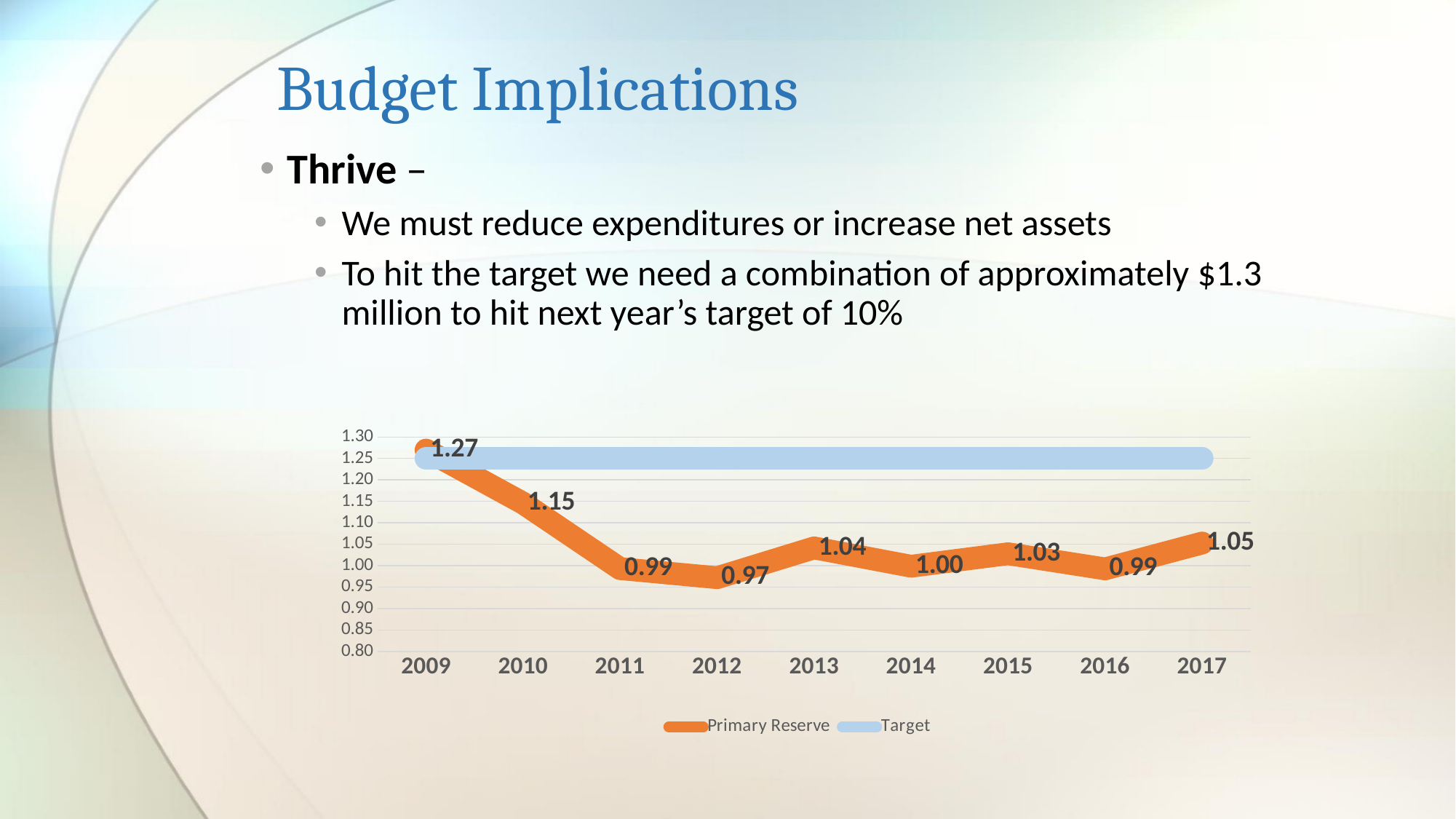
In which year is the Primary Reserve lowest? 2012 How many series does the legend list? 2 How many years are shown on the x axis? 9 What is the Primary Reserve value for 2009? 1.27 Which year has a higher Primary Reserve, 2013 or 2014? 2013 What is the Primary Reserve value for 2012? 0.97 What kind of chart is shown on the slide? line chart What is the difference between the Primary Reserve in 2009 and in 2010? 0.12 Is the Target line value greater or less than 1.20? greater Which series is drawn in orange? Primary Reserve What is the Primary Reserve value for 2017? 1.05 In which year is the Primary Reserve highest? 2009